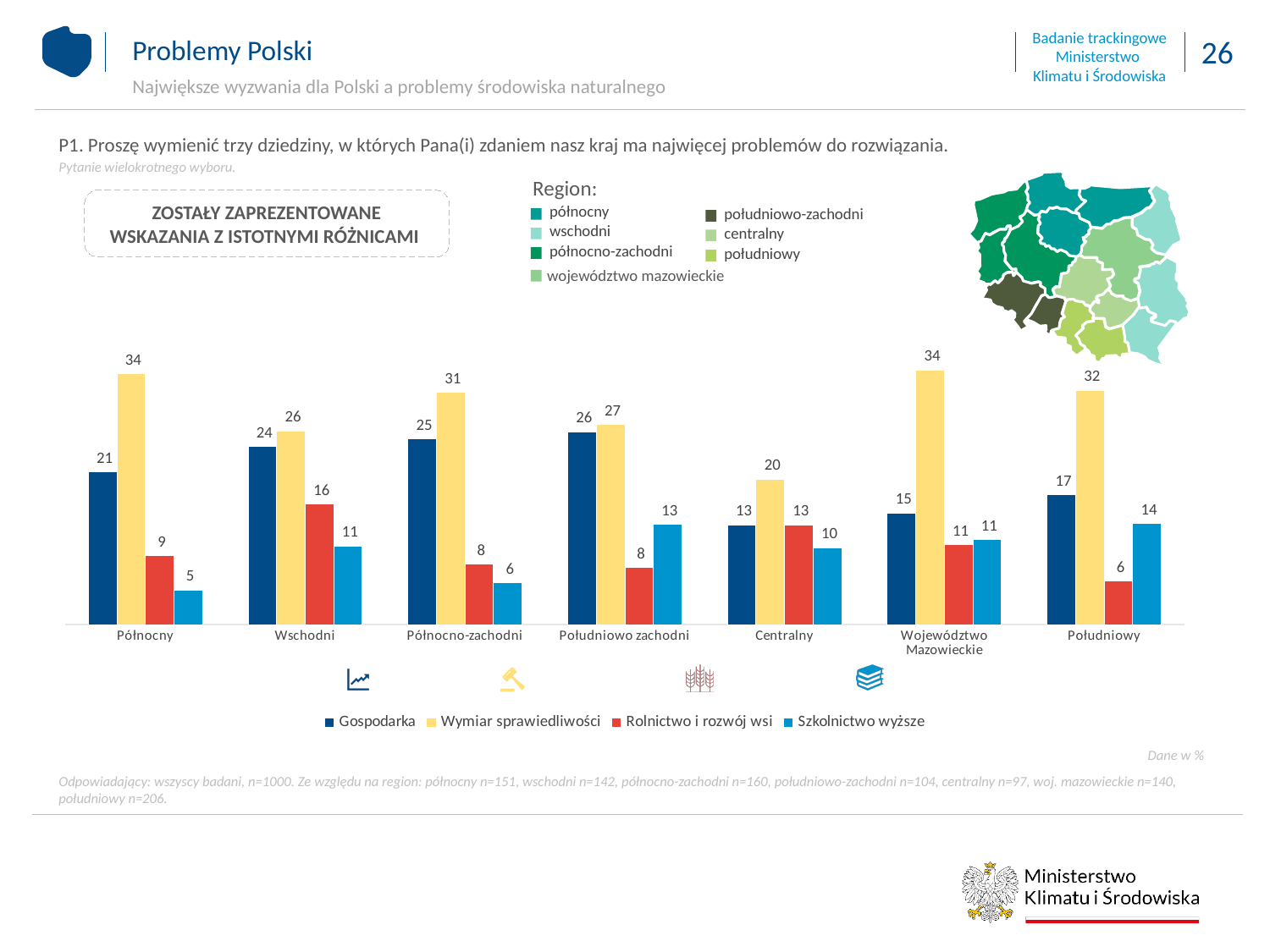
Which region has the highest value for Gospodarka? Południowo zachodni How many regions are shown on the x axis of the chart? 7 What is the value for Szkolnictwo wyższe in the Południowy region? 14 Which region has the lowest value for Szkolnictwo wyższe? Północny Which is larger in the Centralny region: Wymiar sprawiedliwości or Szkolnictwo wyższe? Wymiar sprawiedliwości What kind of chart is shown on the slide? Bar chart What is the difference between Wymiar sprawiedliwości and Gospodarka in the Północno-zachodni region? 6 What is the value for Gospodarka in the Północny region? 21 How many series does the chart legend list? 4 What is the value for Wymiar sprawiedliwości in the Województwo Mazowieckie region? 34 Which series is shown in yellow in the chart? Wymiar sprawiedliwości What is the value for Rolnictwo i rozwój wsi in the Wschodni region? 16